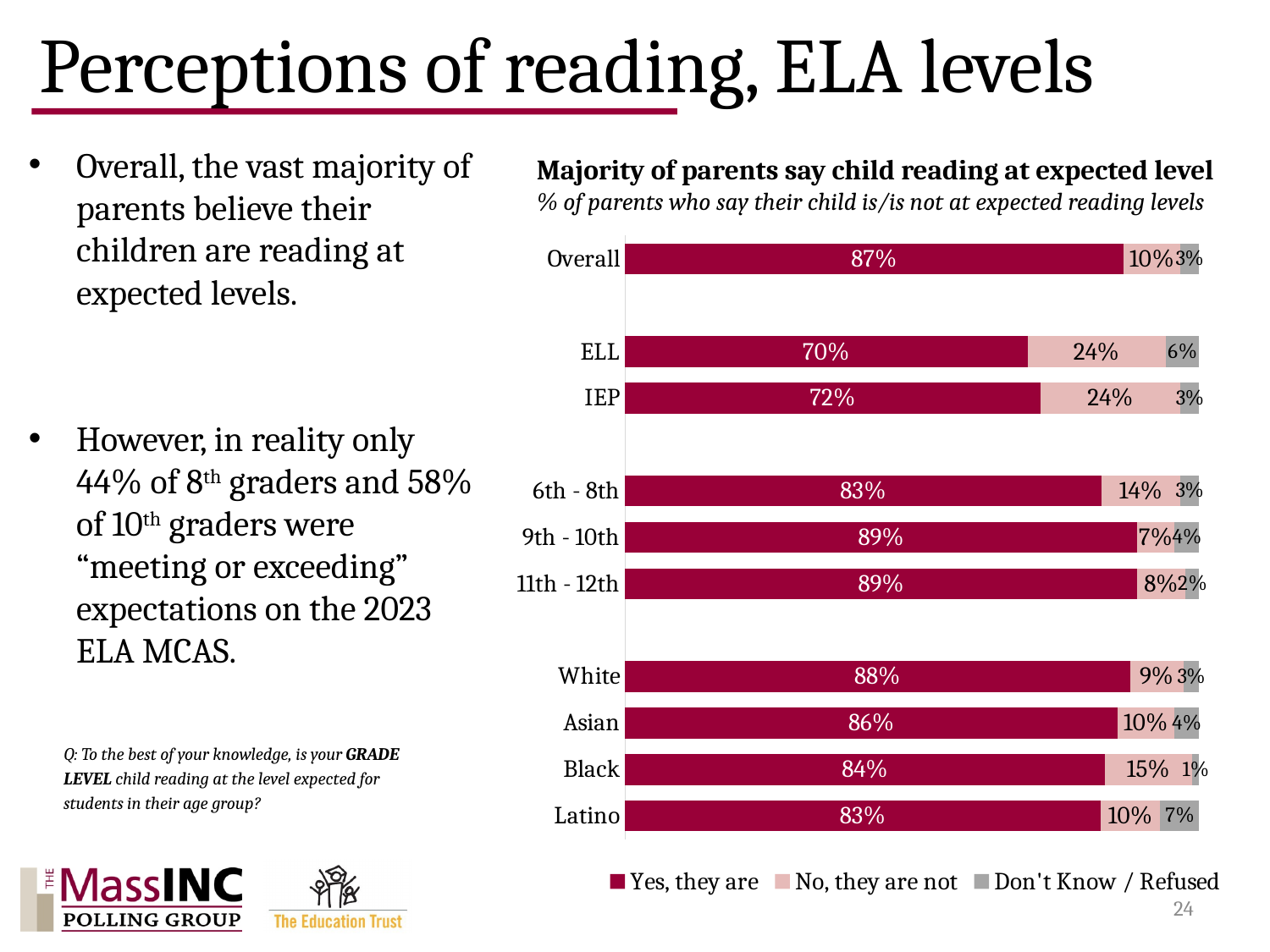
Which category has the highest "No, they are not" percentage among the race/ethnicity groups (White, Asian, Black, Latino)? Black What is the "No, they are not" value for the Black category? 15% Which category has the lowest "Yes, they are" percentage? ELL What percentage of ELL parents say their child is reading at the expected level ("Yes, they are")? 70% What is the "Don't Know / Refused" value for Latino parents? 7% Which has a larger "Yes, they are" value, 6th - 8th or 9th - 10th? 9th - 10th What is the title of the chart? Majority of parents say child reading at expected level What is the total of the three segments in the ELL bar? 100% How many categories are shown on the chart? 10 What is the difference between the Overall "Yes, they are" value and the IEP "Yes, they are" value? 15% How many series does the legend list? 3 What kind of chart is shown on the slide? Stacked bar chart